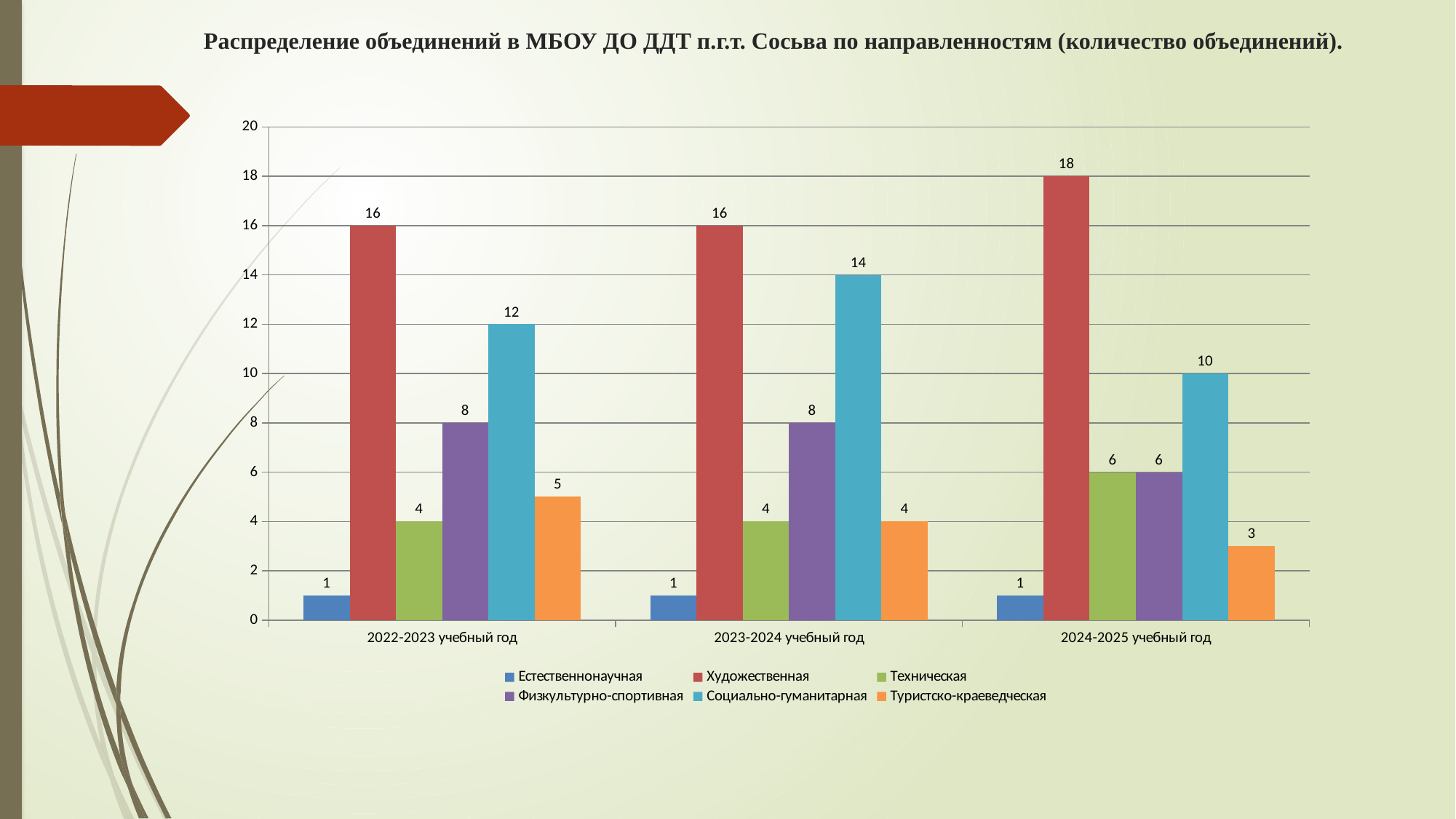
How many categories (school years) are shown on the x axis? 3 What is the value for Туристско-краеведческая in 2022-2023 учебный год? 5 What is the value for Социально-гуманитарная in 2023-2024 учебный год? 14 What is the value for Художественная in 2024-2025 учебный год? 18 What is the difference between Художественная and Социально-гуманитарная in 2024-2025 учебный год? 8 Which is larger: Техническая in 2024-2025 учебный год or Техническая in 2022-2023 учебный год? Техническая in 2024-2025 учебный год How many series does the legend list? 6 How does the value for Туристско-краеведческая change from 2022-2023 to 2024-2025 учебный год? It falls Which series has the highest value in 2024-2025 учебный год? Художественная What kind of chart is shown on the slide? Bar chart Which series has the lowest value in 2022-2023 учебный год? Естественнонаучная What colour represents Физкультурно-спортивная in the legend? Purple